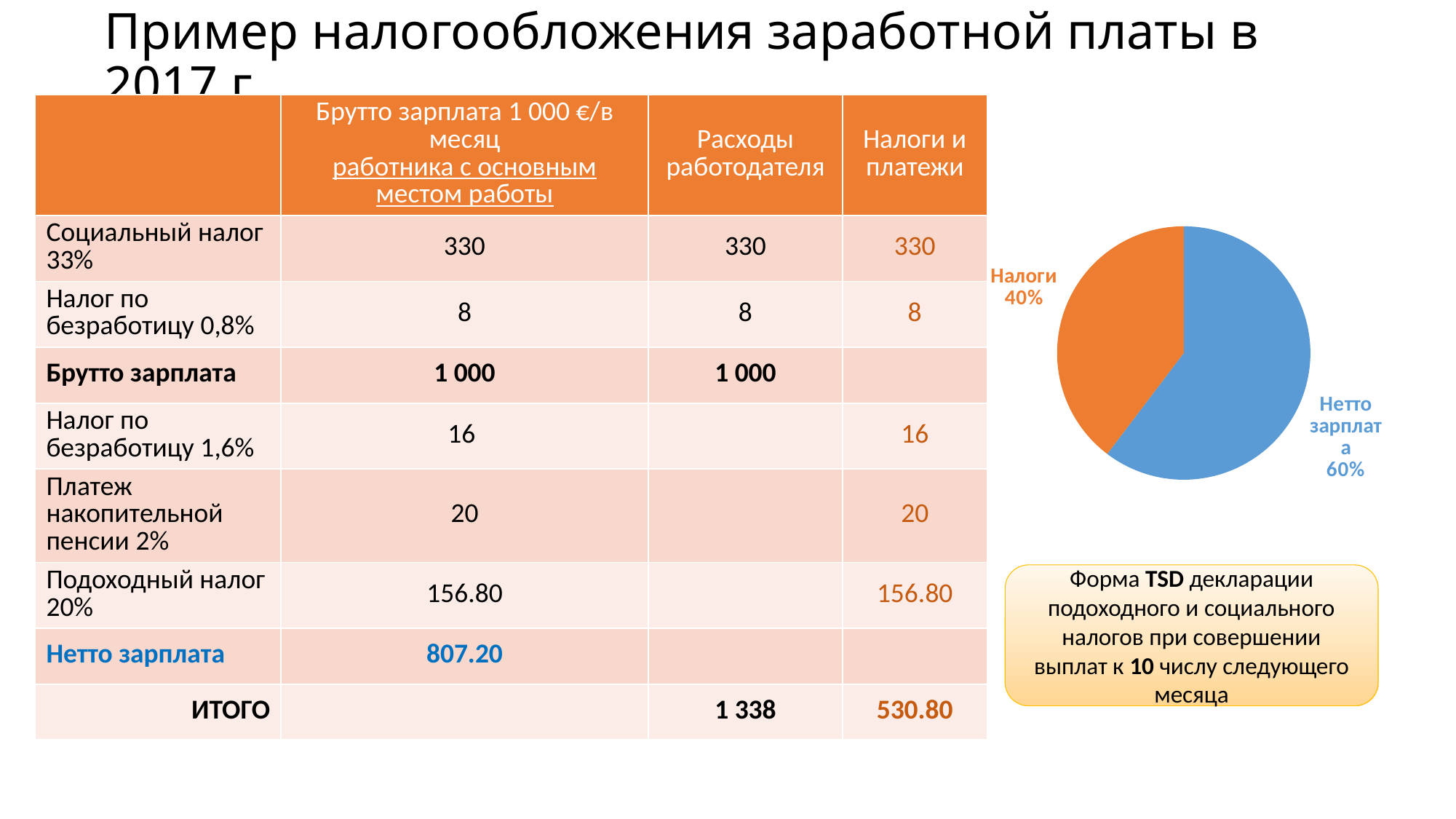
What share of the pie chart is labelled "Нетто зарплата"? 60% What kind of chart is shown on the right side of the slide? pie chart What is the difference in percentage points between the Нетто зарплата slice and the Налоги slice in the pie chart? 20 How many slices does the pie chart have? 2 What share of the pie chart is labelled "Налоги"? 40% What colour is the Налоги slice in the pie chart? orange What colour is the Нетто зарплата slice in the pie chart? blue In the pie chart, which is larger: Налоги or Нетто зарплата? Нетто зарплата Which slice of the pie chart is the smallest? Налоги Which slice of the pie chart is the largest? Нетто зарплата